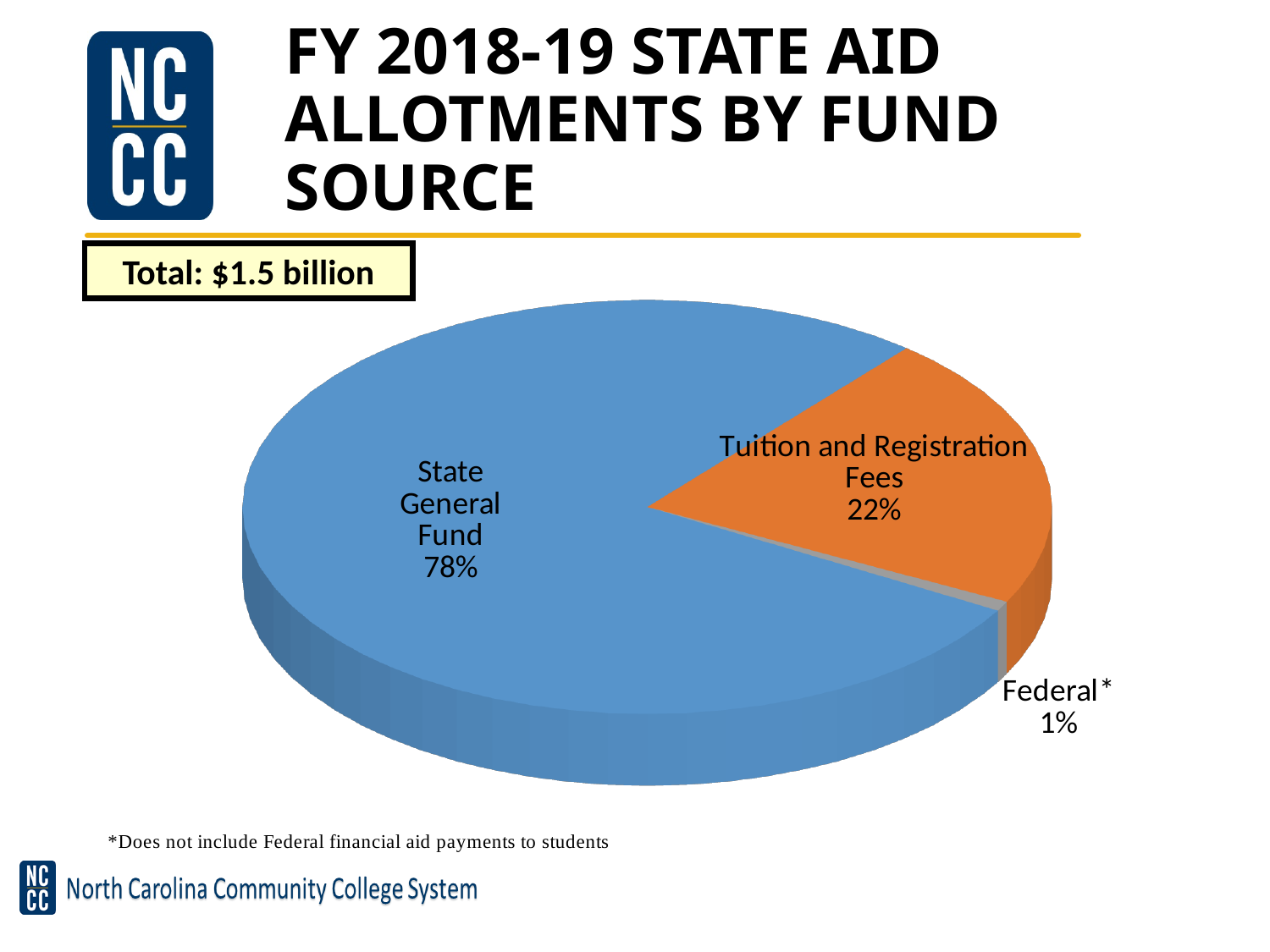
Which fund source has the smallest share of the allotments? Federal How many fund sources are shown in the pie chart? 3 What colour is the State General Fund slice? Blue What is the difference in percentage points between the Tuition and Registration Fees share and the Federal share? 21 What share of the FY 2018-19 state aid allotments comes from the State General Fund? 78% Which is larger, the share for Tuition and Registration Fees or the share for Federal? Tuition and Registration Fees What type of chart is shown on the slide? Pie chart What share of the allotments comes from Federal sources? 1% What share of the allotments comes from Tuition and Registration Fees? 22% Which fund source has the largest share of the allotments? State General Fund What total amount is stated for the allotments on the slide? $1.5 billion What is the difference in percentage points between the State General Fund share and the Tuition and Registration Fees share? 56